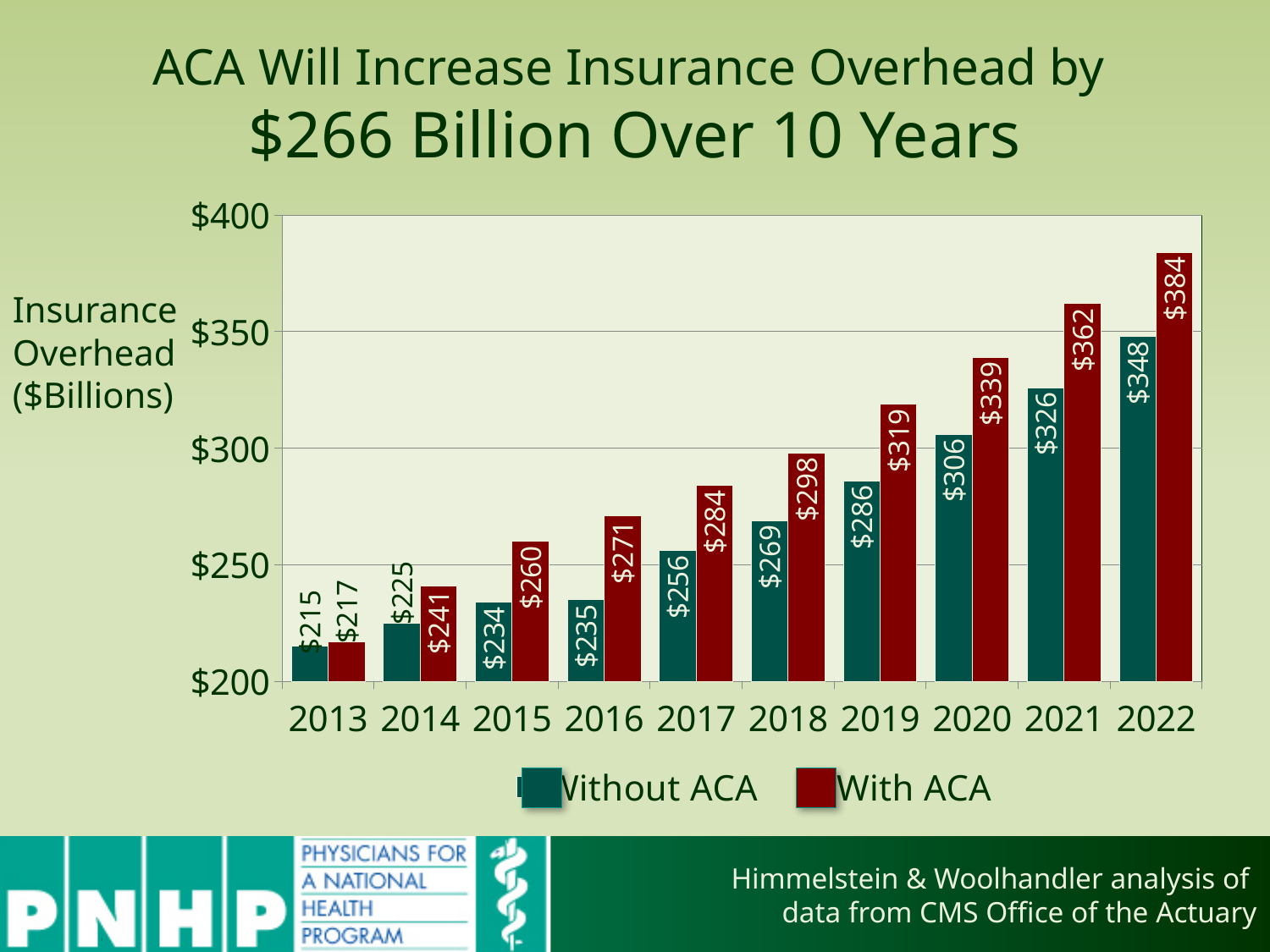
What is the value for With ACA in 2016? $271 What kind of chart is shown on the slide? bar chart Which is larger in 2020: the With ACA value or the Without ACA value? With ACA How many series does the legend list? 2 Do the With ACA values rise or fall from 2013 to 2022? rise How many years are shown on the x axis? 10 What is the difference between the With ACA and Without ACA values in 2022? $36 Which year has the highest Without ACA value? 2022 Is the Without ACA value for 2021 greater or less than $300? greater Which year has the lowest With ACA value? 2013 What is the value for Without ACA in 2019? $286 What is the value for With ACA in 2022? $384